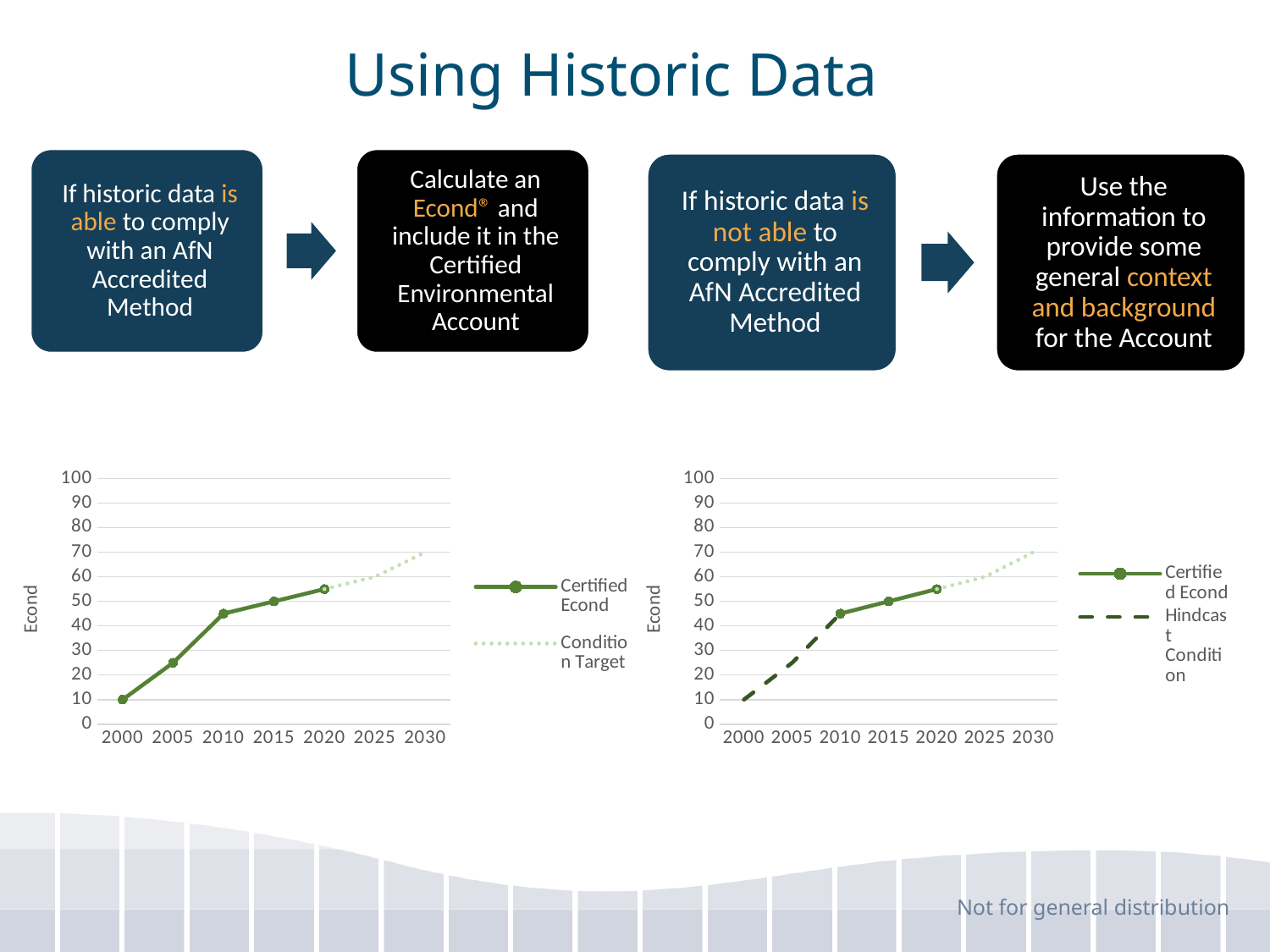
What is the label on the vertical axis of the right chart? Econd In the left chart, what is the Certified Econd value in 2000? 10 In the left chart, how many series does the legend list? 2 In the left chart, which is larger, the Certified Econd value in 2010 or in 2005? 2010 In the left chart, does the Certified Econd line rise or fall from 2000 to 2020? rises In the right chart, what are the two series named in the legend? Certified Econd and Hindcast Condition What kind of chart is the left chart? line chart In the right chart, is the Certified Econd value in 2020 greater or less than 60? less In the left chart, what is the Certified Econd value in 2015? 50 In the right chart, which year has the lowest Hindcast Condition value? 2000 In the left chart, is the Certified Econd value in 2005 greater or less than 30? less In the left chart, is the Certified Econd value in 2010 greater or less than 40? greater